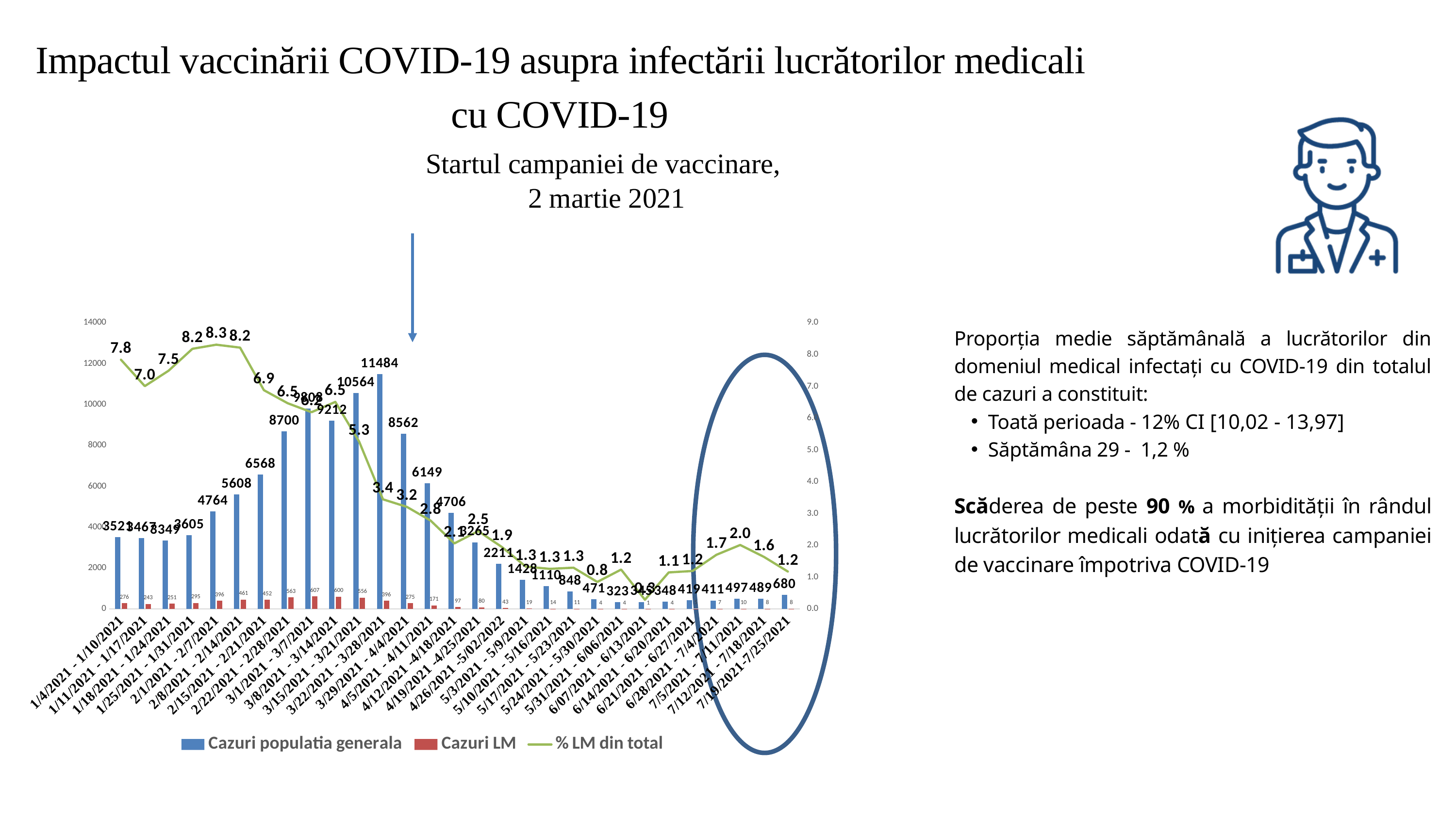
Which week has the highest value for Cazuri populatia generala? 3/22/2021 - 3/28/2021 How many weekly periods are plotted along the x axis? 29 In which week does the % LM din total line reach its highest value, and what is that value? 2/1/2021 - 2/7/2021, 8.3 What kind of chart is shown on the slide? Combination bar and line chart What are the three series named in the chart legend? Cazuri populatia generala, Cazuri LM, % LM din total What is the % LM din total value for the week 1/4/2021 - 1/10/2021? 7.8 Does the % LM din total line rise or fall from the week 3/22/2021 - 3/28/2021 to the week 5/24/2021 - 5/30/2021? Falls What is the value of Cazuri LM for the week 3/1/2021 - 3/7/2021? 607 Which week has the larger value for Cazuri populatia generala: 2/8/2021 - 2/14/2021 or 2/15/2021 - 2/21/2021? 2/15/2021 - 2/21/2021 What is the value of Cazuri populatia generala for the week 3/22/2021 - 3/28/2021? 11484 What is the difference in Cazuri populatia generala between the weeks 3/22/2021 - 3/28/2021 and 3/29/2021 - 4/4/2021? 2922 How many series does the chart legend list? 3